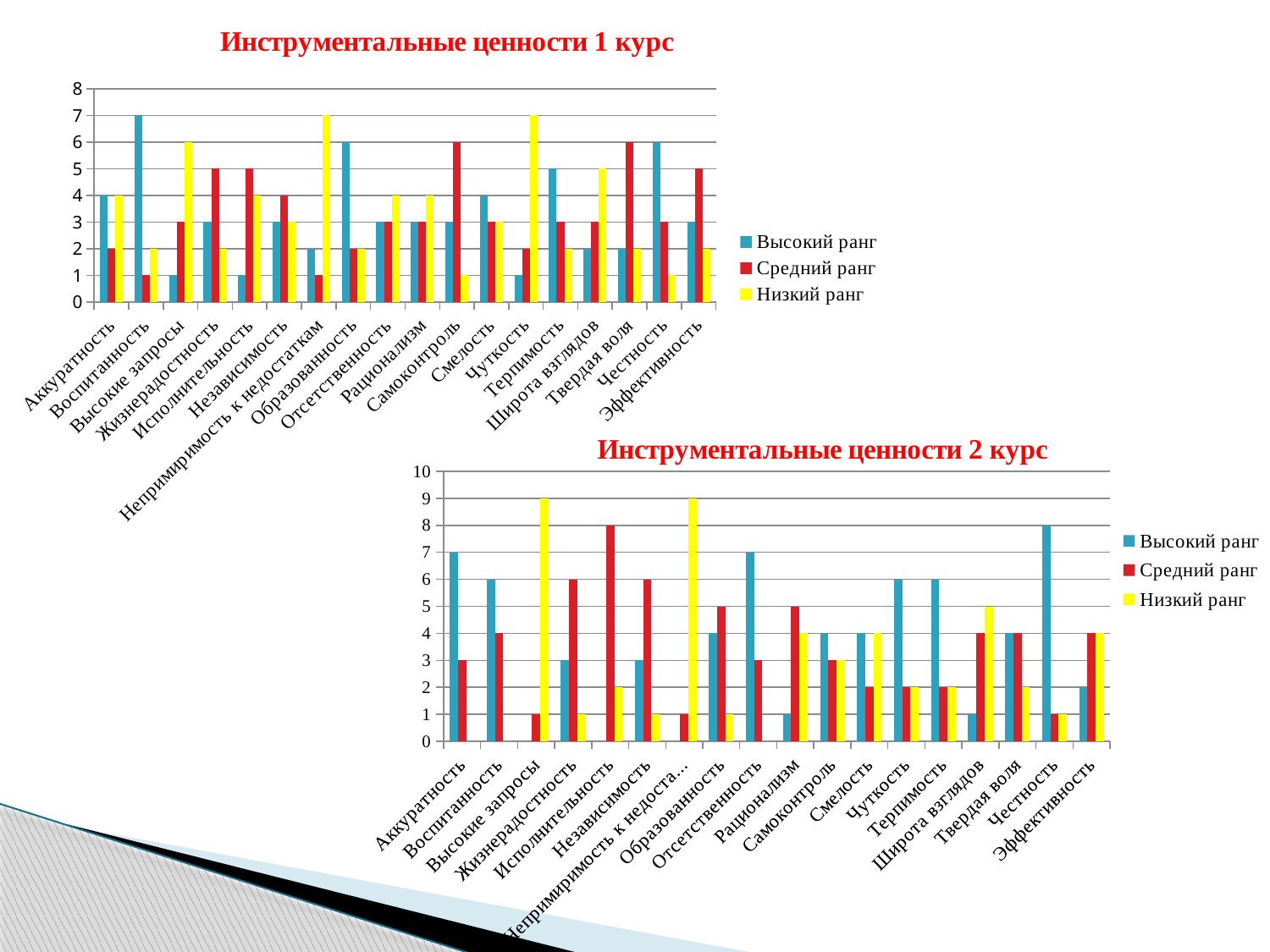
In the chart "Инструментальные ценности 2 курс", how many series does the legend list? 3 In the chart "Инструментальные ценности 2 курс", is the value of Средний ранг for Исполнительность greater or less than 5? greater In the chart "Инструментальные ценности 2 курс", what is the difference between Высокий ранг and Средний ранг for Честность? 7 In the chart "Инструментальные ценности 1 курс", for Образованность, which is larger: Высокий ранг or Средний ранг? Высокий ранг In the chart "Инструментальные ценности 2 курс", which category has the highest value for Средний ранг? Исполнительность In the chart "Инструментальные ценности 2 курс", which category has the highest value for Высокий ранг? Честность In the chart "Инструментальные ценности 1 курс", how many categories are shown on the x axis? 18 In the chart "Инструментальные ценности 2 курс", what is the value of Низкий ранг for Высокие запросы? 9 What is the title of the top chart on the slide? Инструментальные ценности 1 курс In the chart "Инструментальные ценности 1 курс", which category has the highest value for Высокий ранг? Воспитанность In the chart "Инструментальные ценности 1 курс", what is the value of Средний ранг for Самоконтроль? 6 What kind of chart is the top chart titled "Инструментальные ценности 1 курс"? bar chart